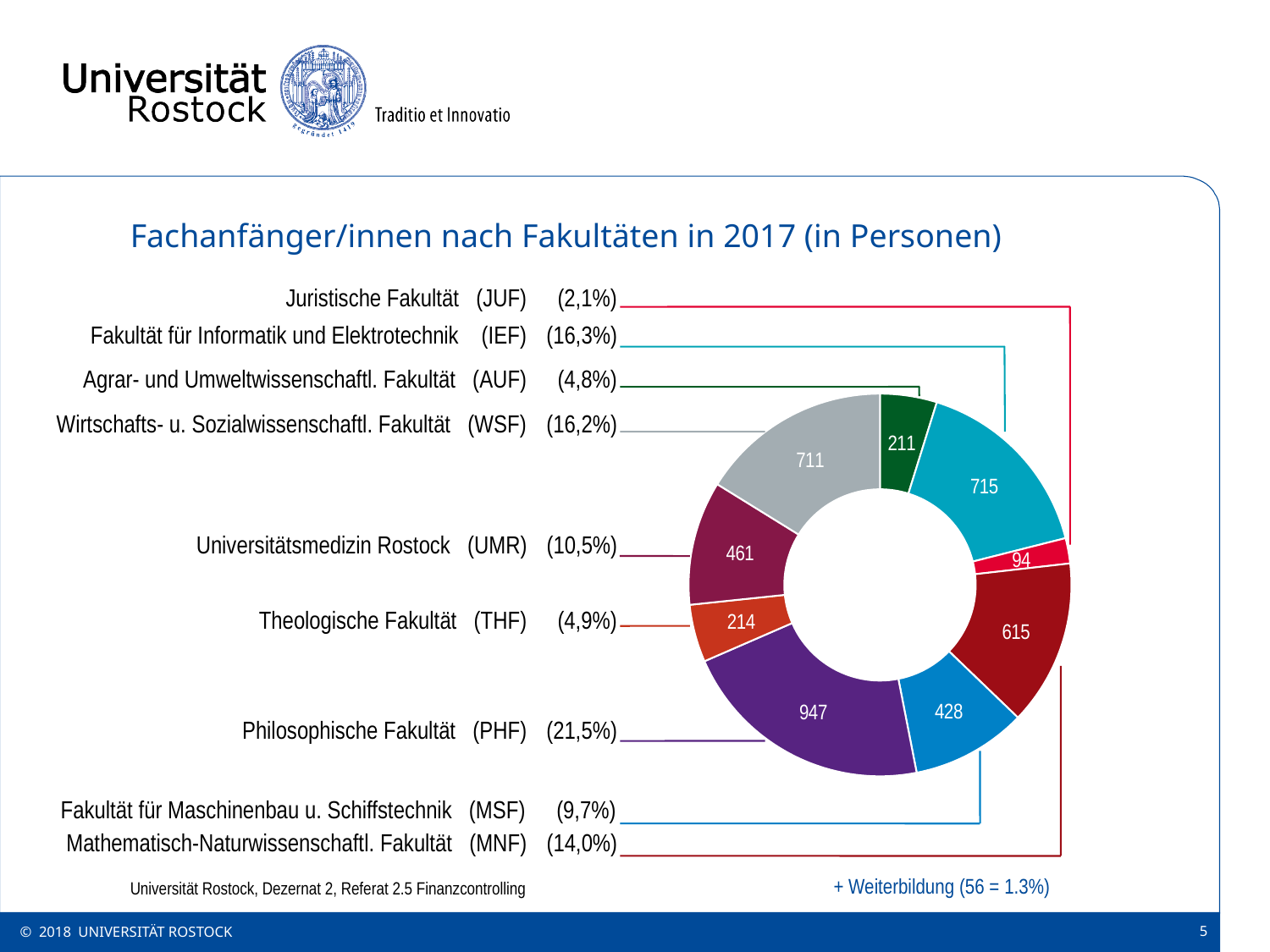
How many faculties (slices) are shown in the chart? 9 What is the value for the Juristische Fakultät (JUF)? 94 Which has more Fachanfänger/innen, Universitätsmedizin Rostock (UMR) or Theologische Fakultät (THF)? Universitätsmedizin Rostock (UMR) Which faculty has the highest number of Fachanfänger/innen? Philosophische Fakultät (PHF) What type of chart is shown on the slide? Donut (pie) chart How many Fachanfänger/innen does the Philosophische Fakultät (PHF) have? 947 What share of the total does the Philosophische Fakultät (PHF) represent? 21,5% Which faculty has the lowest number of Fachanfänger/innen? Juristische Fakultät (JUF) What is the title of the chart? Fachanfänger/innen nach Fakultäten in 2017 (in Personen) What is the difference between the values for PHF and JUF? 853 What is the value for the Fakultät für Informatik und Elektrotechnik (IEF)? 715 What is the value for the Fakultät für Maschinenbau u. Schiffstechnik (MSF)? 428